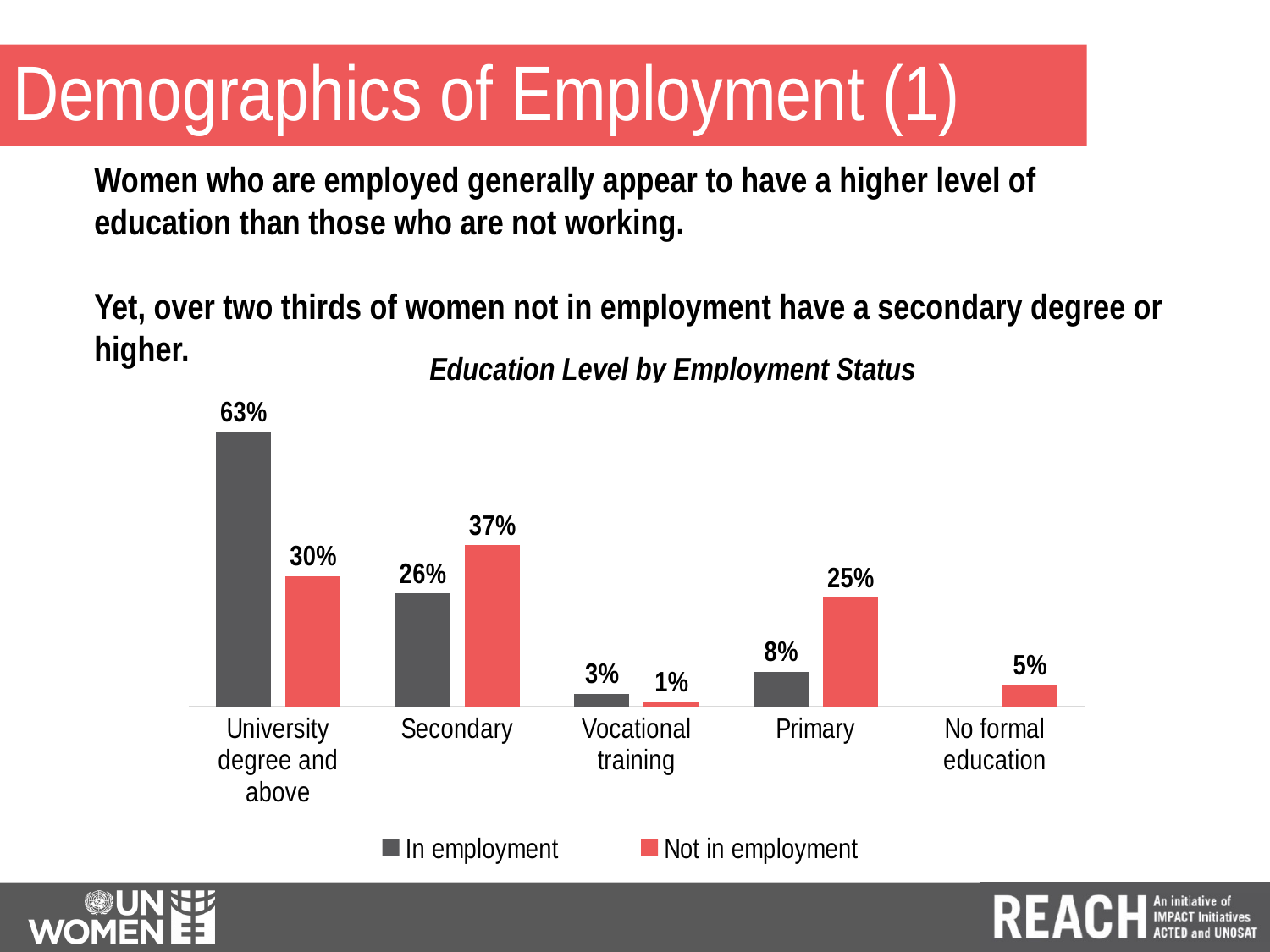
For Secondary, which series has the larger value: In employment or Not in employment? Not in employment What is the title of the chart? Education Level by Employment Status What kind of chart is shown on the slide? Bar chart How many series does the legend list? 2 Which education level has the highest value for the In employment series? University degree and above What percentage of women not in employment have a secondary education? 37% What is the difference between the In employment and Not in employment values for University degree and above? 33 percentage points Which education level has the lowest value for the Not in employment series? Vocational training What is the value for Primary among women not in employment? 25% What is the value for No formal education among women not in employment? 5% What percentage of women in employment have a university degree and above? 63% How many education level categories are shown on the x axis? 5